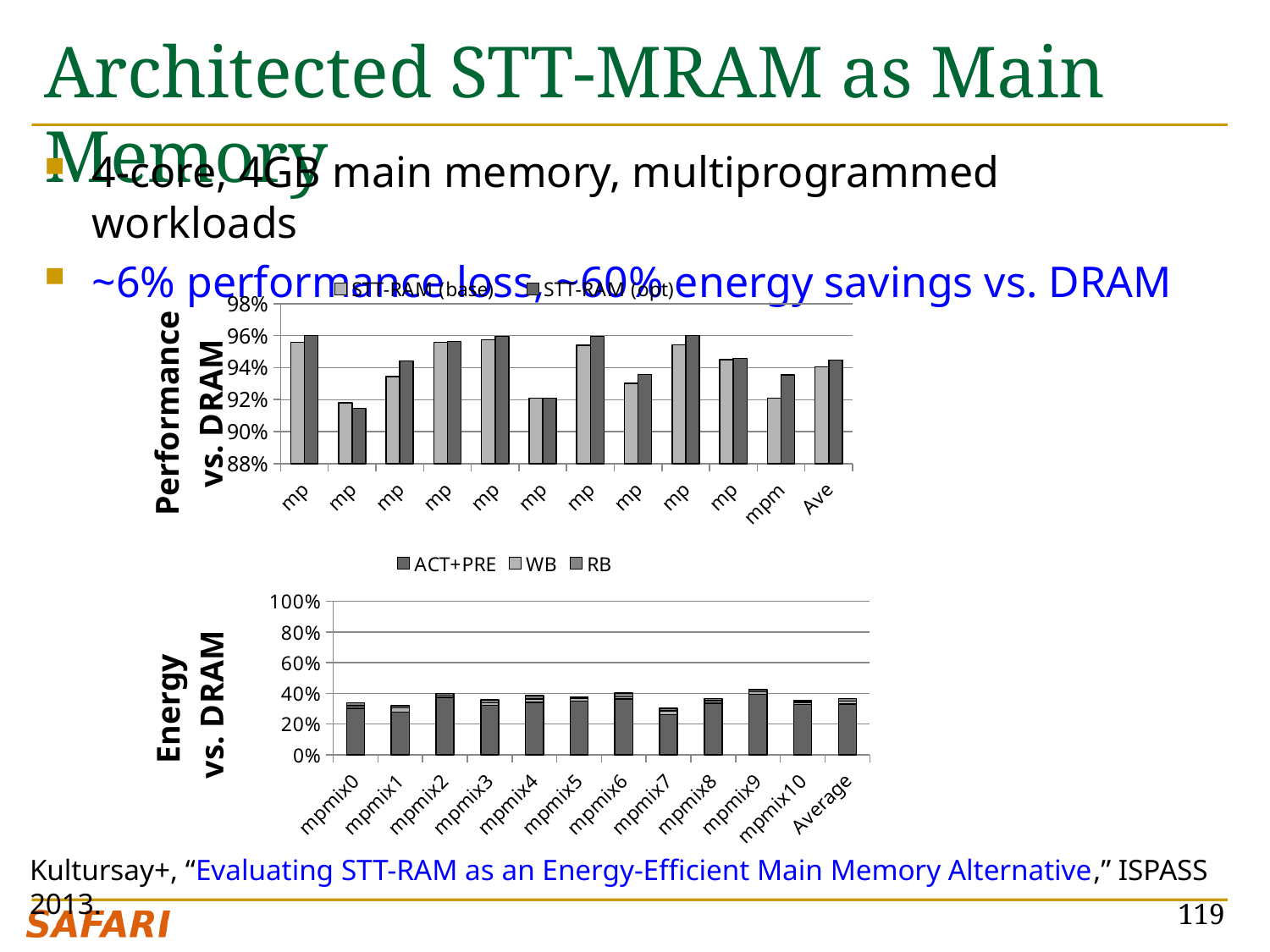
What are the legend entries of the bottom chart, Energy vs. DRAM? ACT+PRE, WB, RB In the bottom chart, Energy vs. DRAM, is the total stacked value for Average greater or less than 60%? less How many series does the legend of the bottom chart, Energy vs. DRAM, list? 3 In the top chart, Performance vs. DRAM, how many categories are shown on the x axis? 12 How many series does the legend of the top chart, Performance vs. DRAM, list? 2 In the bottom chart, Energy vs. DRAM, how many categories are shown on the x axis? 12 In the top chart, Performance vs. DRAM, is the STT-RAM (base) value for mpm greater or less than 94%? less What kind of chart is the top chart, Performance vs. DRAM? bar chart In the top chart, Performance vs. DRAM, is the STT-RAM (opt) value for Ave greater or less than 92%? greater In the bottom chart, Energy vs. DRAM, which has the taller stacked bar, mpmix9 or mpmix7? mpmix9 What kind of chart is the bottom chart, Energy vs. DRAM? bar chart